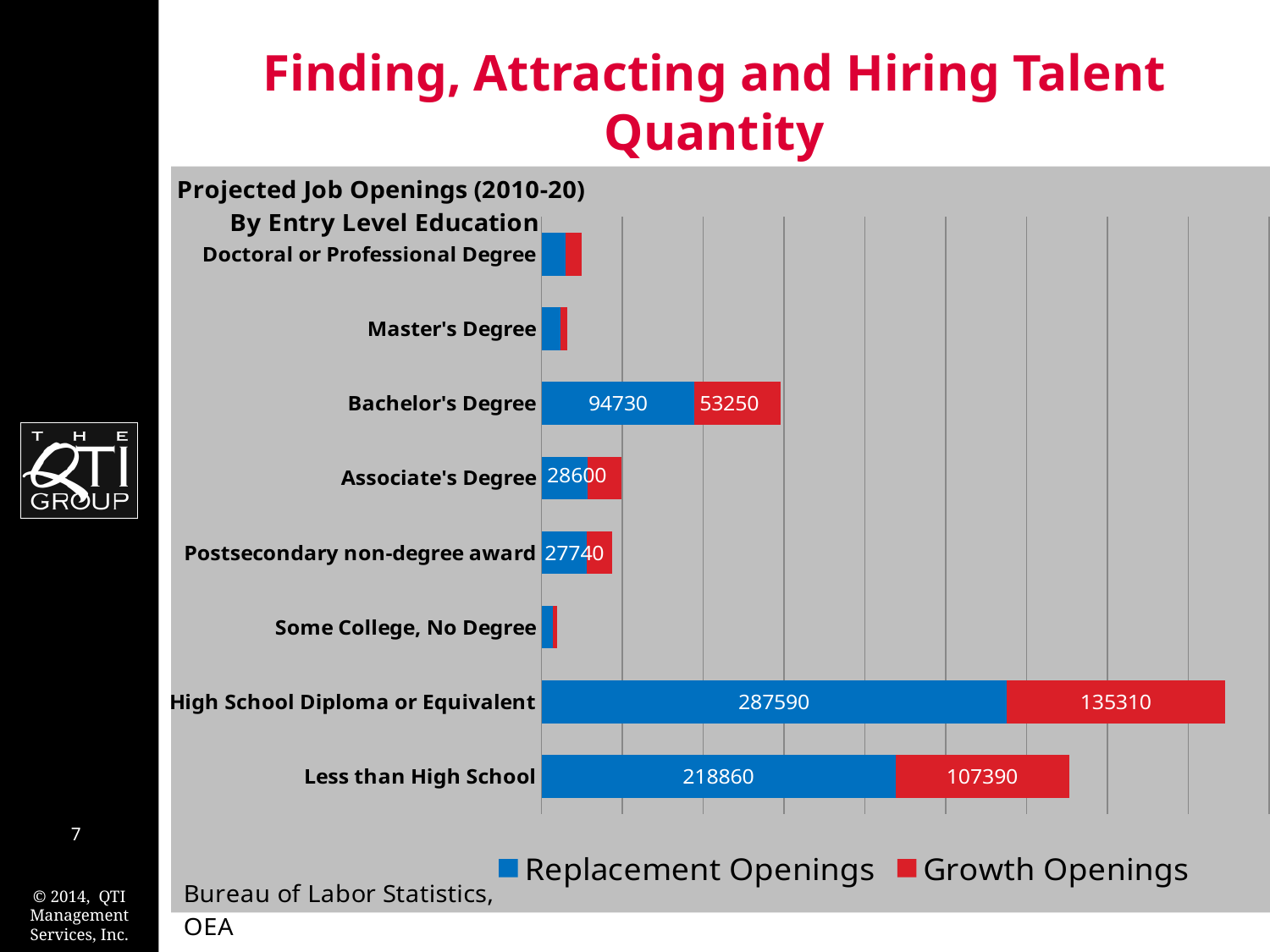
What is the value of Growth Openings for Less than High School? 107390 What is the value of Replacement Openings for Bachelor's Degree? 94730 What is the value of Replacement Openings for Associate's Degree? 28600 How many series does the legend list? 2 Which education category has the largest total projected job openings? High School Diploma or Equivalent Which education category has the smallest total projected job openings? Some College, No Degree What is the title of the chart? Projected Job Openings (2010-20) By Entry Level Education What is the value of Replacement Openings for High School Diploma or Equivalent? 287590 How many education categories are shown in the chart? 8 What type of chart is shown on the slide? Stacked bar chart What is the difference between Replacement Openings and Growth Openings for Bachelor's Degree? 41480 What is the total projected job openings for High School Diploma or Equivalent? 422900